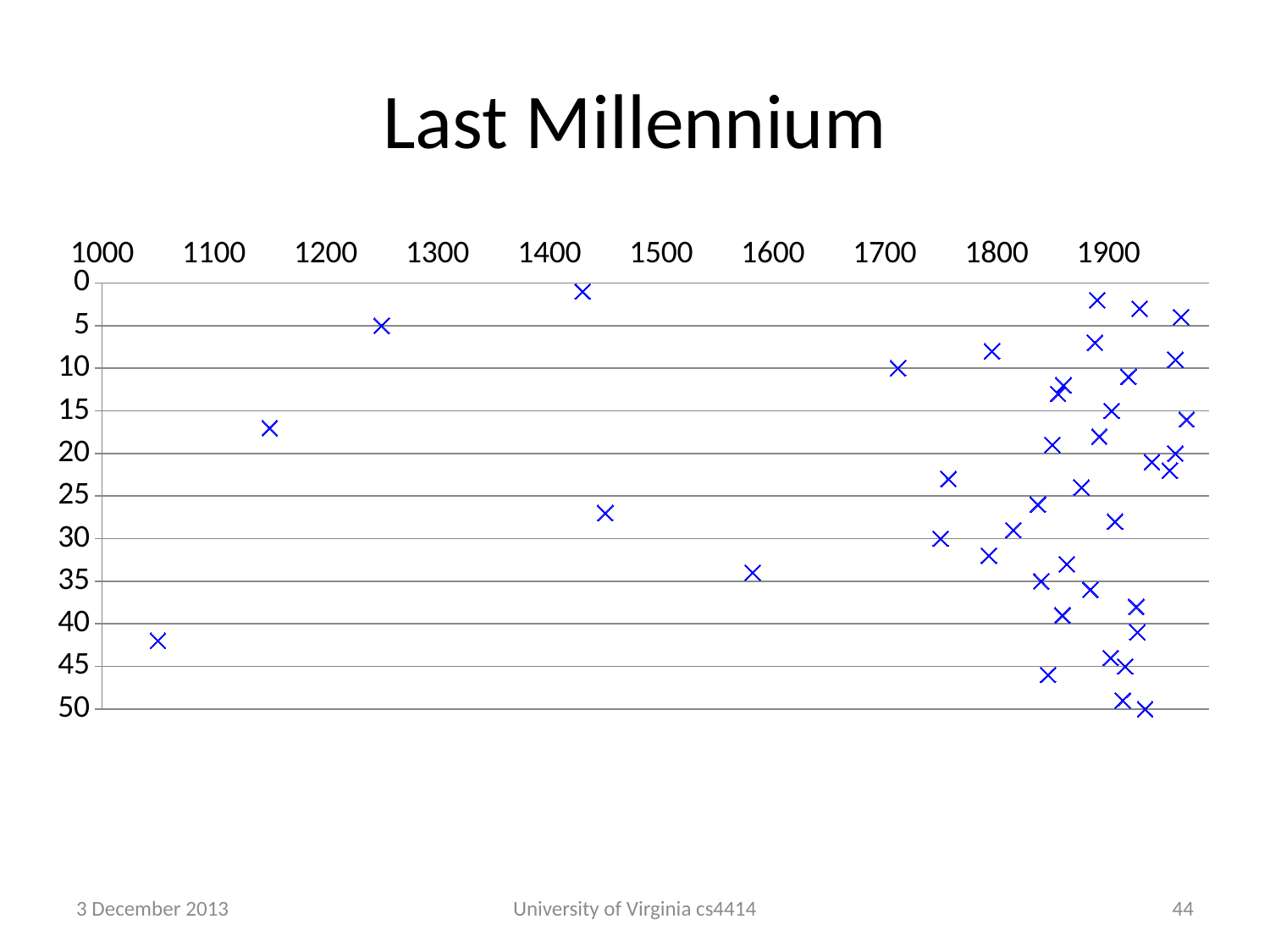
Is the y value of the point near x = 1150 greater or less than 10? greater What kind of chart is shown on the slide? scatter chart What is the largest value labeled on the x axis of the chart? 1900 Is the y value of the point near x = 1430 greater or less than 5? less Is the y value of the point near x = 1580 greater or less than 30? greater What is the title of the chart? Last Millennium